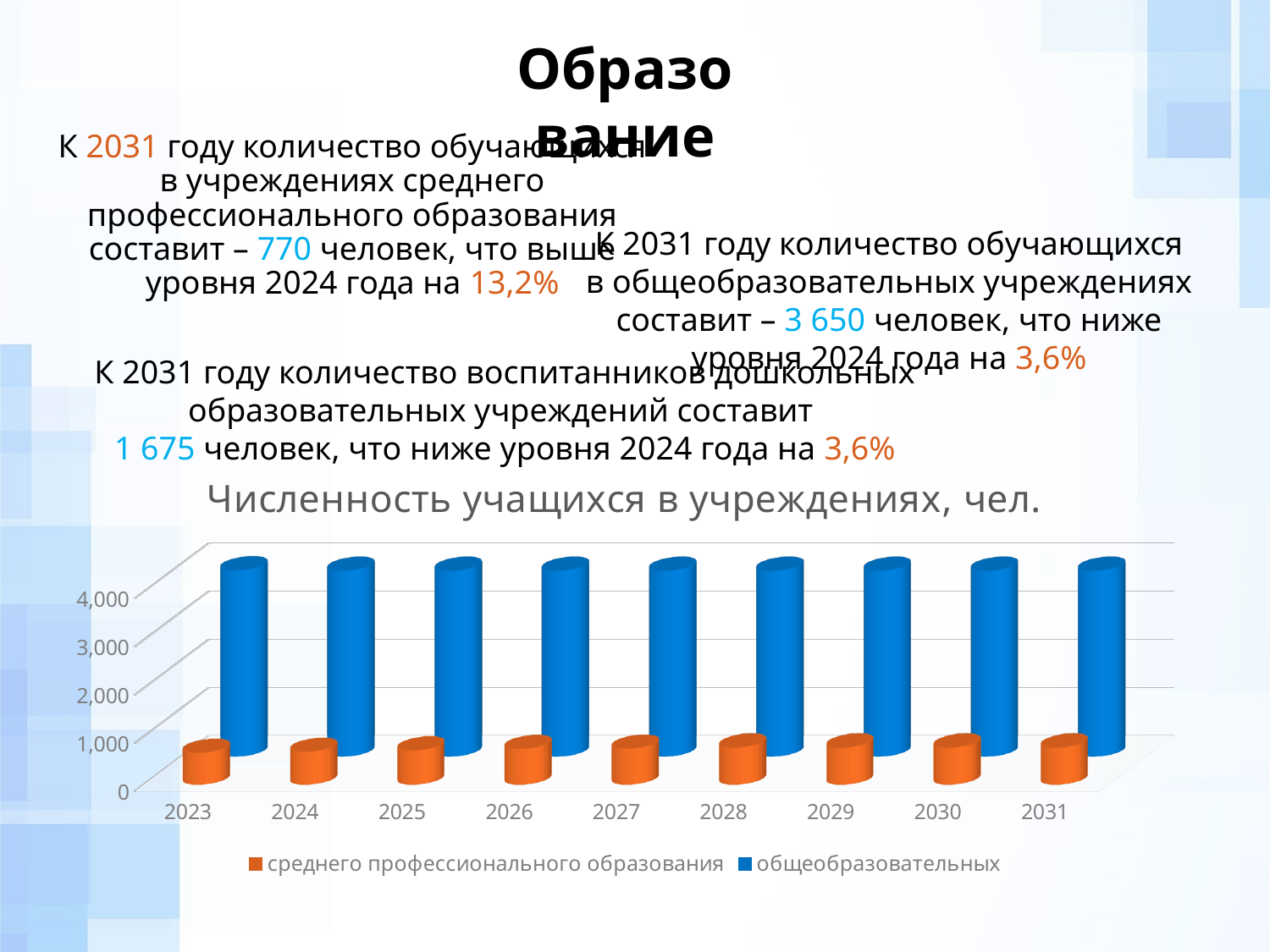
What is the title of the chart? Численность учащихся в учреждениях, чел. Which series is shown in blue in the chart? общеобразовательных Is the value for среднего профессионального образования in 2031 greater or less than 2,000? less In 2027, which series has the larger value: среднего профессионального образования or общеобразовательных? общеобразовательных Is the value for общеобразовательных in 2023 greater or less than 3,000? greater What kind of chart is shown on the slide? bar chart How many series does the chart legend list? 2 Is the value for общеобразовательных in 2031 greater or less than 2,000? greater What is the last year shown on the x axis of the chart? 2031 In 2024, which series has the smaller value: среднего профессионального образования or общеобразовательных? среднего профессионального образования What is the first year shown on the x axis of the chart? 2023 How many years are shown on the x axis of the chart? 9